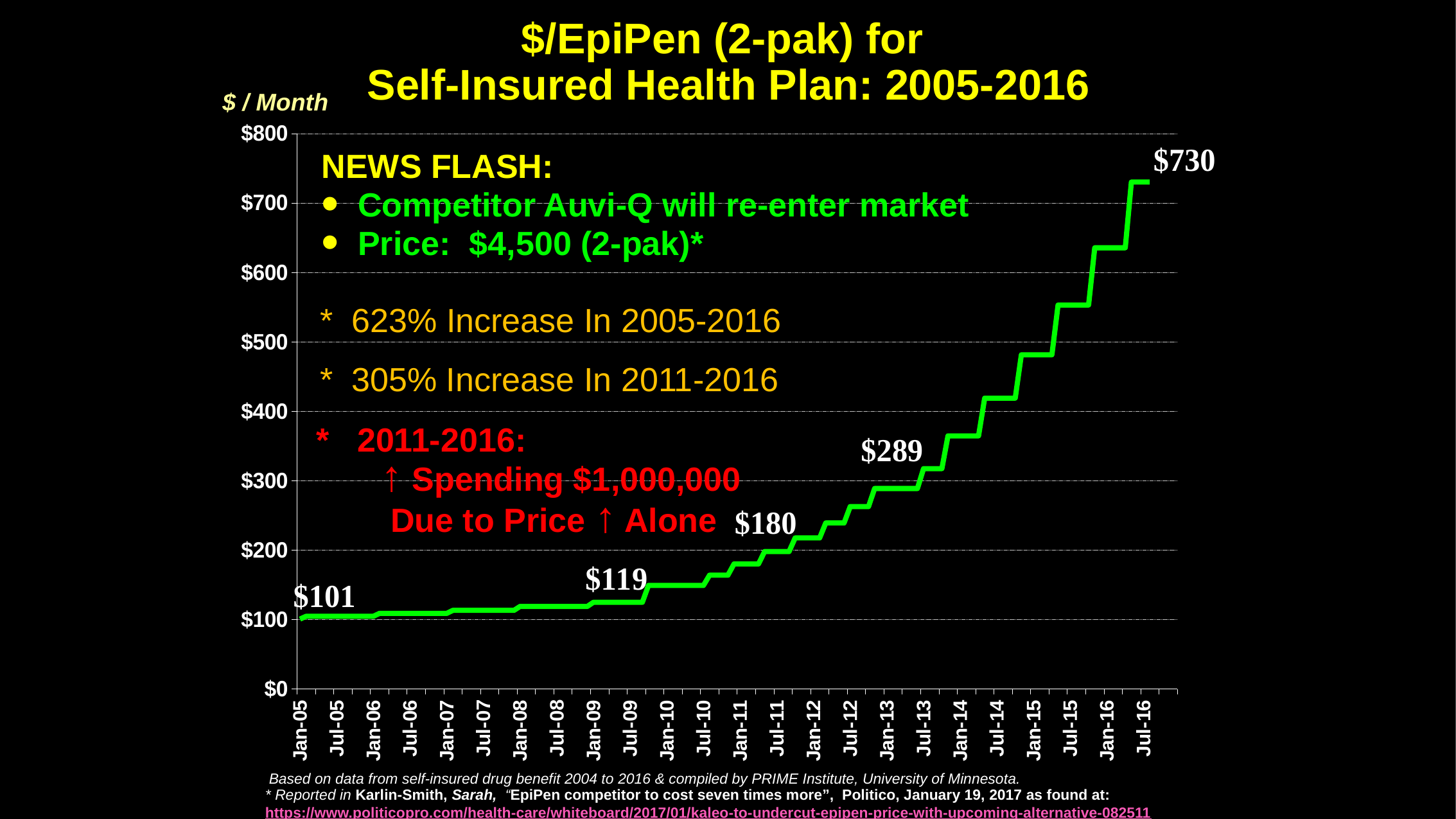
What value is labeled at the end of the line, at Jul-16? $730 Is the value at Jan-14 greater or less than $300? greater What is the title of the chart? $/EpiPen (2-pak) for Self-Insured Health Plan: 2005-2016 Is the value at Jan-10 greater or less than $200? less What is the lowest labeled value on the line? $101 What is the label on the vertical axis of the chart? $ / Month What value is labeled at the start of the line, at Jan-05? $101 How many lines are plotted on the chart? 1 What type of chart is shown on the slide? line chart What is the highest labeled value on the line? $730 What is the difference between the labeled value at Jul-16 and the labeled value at Jan-05? $629 Does the line generally rise or fall from Jan-05 to Jul-16? rise